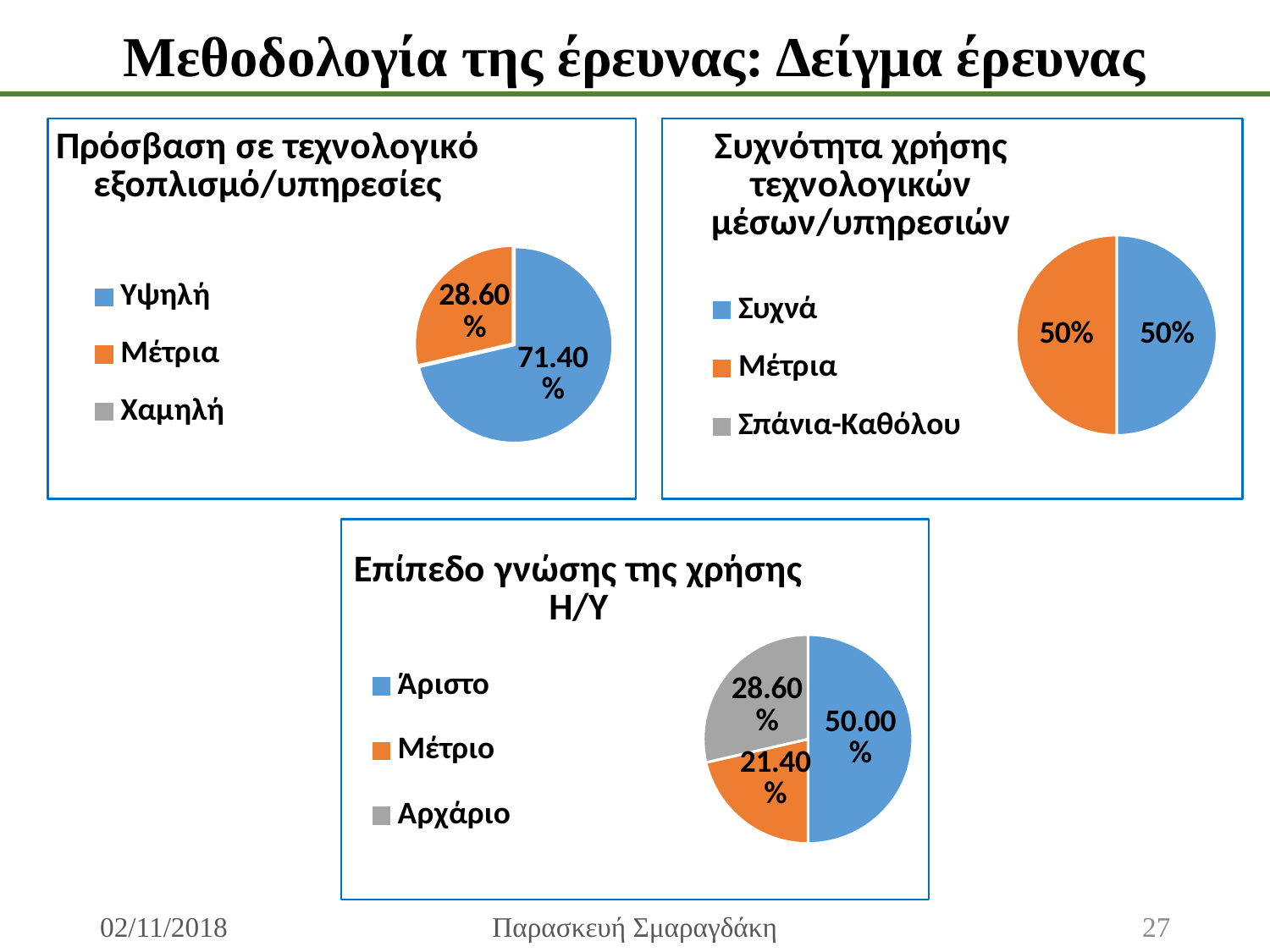
In the chart titled 'Επίπεδο γνώσης της χρήσης Η/Υ', which is larger, Μέτριο or Αρχάριο? Αρχάριο In the chart titled 'Επίπεδο γνώσης της χρήσης Η/Υ', what is the value for Άριστο? 50.00% In the chart titled 'Επίπεδο γνώσης της χρήσης Η/Υ', which category has the smallest slice? Μέτριο In the chart titled 'Συχνότητα χρήσης τεχνολογικών μέσων/υπηρεσιών', what is the value for Συχνά? 50% In the chart titled 'Πρόσβαση σε τεχνολογικό εξοπλισμό/υπηρεσίες', what is the value for Μέτρια? 28.60% In the chart titled 'Πρόσβαση σε τεχνολογικό εξοπλισμό/υπηρεσίες', what is the value for Υψηλή? 71.40% In the chart titled 'Επίπεδο γνώσης της χρήσης Η/Υ', what is the value for Αρχάριο? 28.60% In the chart titled 'Επίπεδο γνώσης της χρήσης Η/Υ', what colour is the Αρχάριο slice? Grey What kind of chart is the chart titled 'Συχνότητα χρήσης τεχνολογικών μέσων/υπηρεσιών'? Pie chart In the chart titled 'Πρόσβαση σε τεχνολογικό εξοπλισμό/υπηρεσίες', what is the difference between the Υψηλή and Μέτρια values? 42.80% In the chart titled 'Συχνότητα χρήσης τεχνολογικών μέσων/υπηρεσιών', how many entries does the legend list? 3 In the chart titled 'Πρόσβαση σε τεχνολογικό εξοπλισμό/υπηρεσίες', which category has the largest slice? Υψηλή